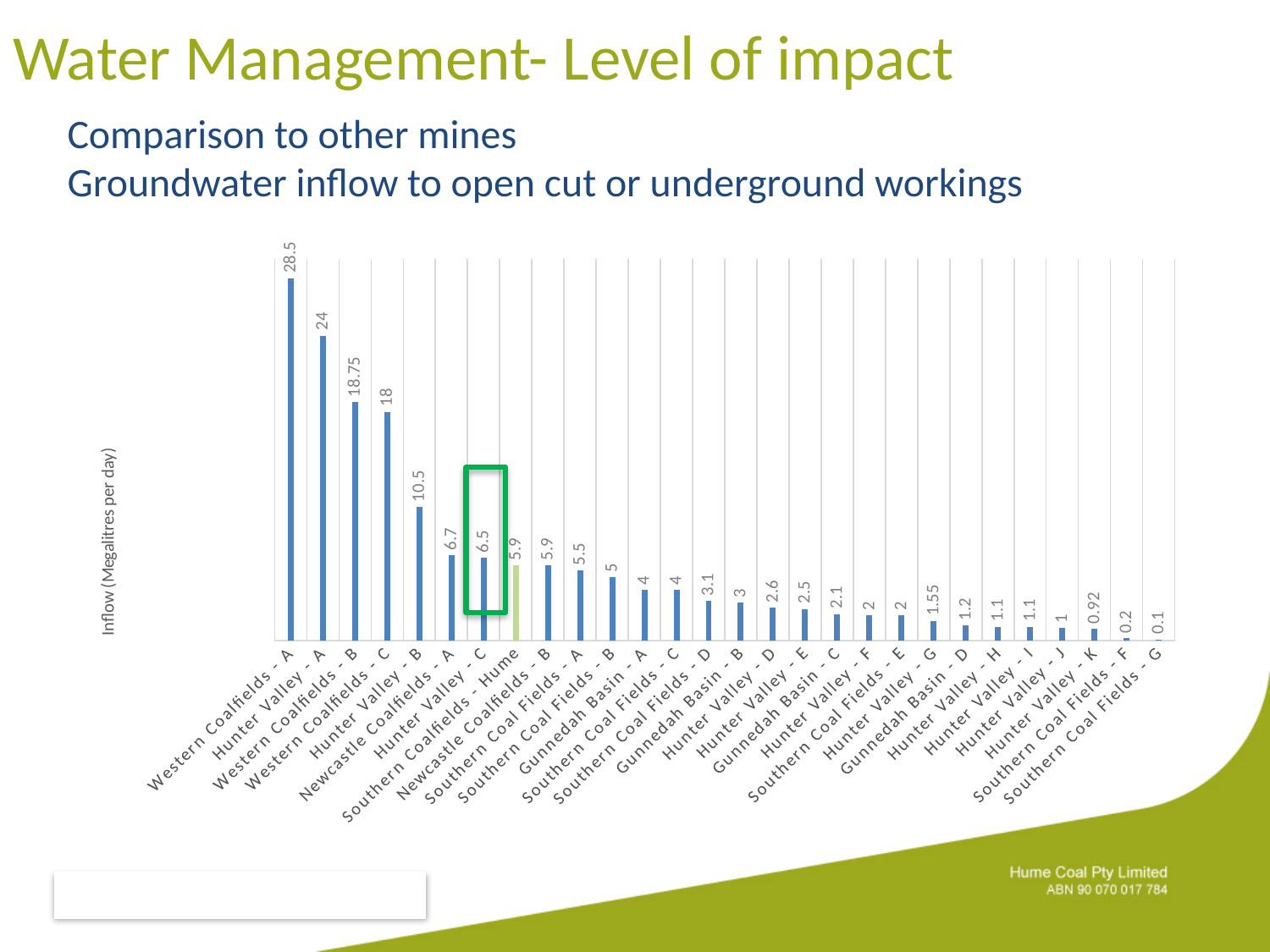
What is the value shown for Southern Coalfields - Hume? 5.9 What is the difference between the values for Western Coalfields - A and Hunter Valley - A? 4.5 What is the label on the vertical axis of the chart? Inflow (Megalitres per day) What is the groundwater inflow value for Western Coalfields - A? 28.5 What is the value shown for Hunter Valley - B? 10.5 Which mine has the highest groundwater inflow? Western Coalfields - A Which is larger, the value for Western Coalfields - B or Hunter Valley - B? Western Coalfields - B What kind of chart is shown on the slide? Bar chart What is the value shown for Hunter Valley - K? 0.92 How many mines are plotted on the chart? 28 What is the difference between the values for Hunter Valley - C and Southern Coalfields - Hume? 0.6 Which mine has the lowest groundwater inflow? Southern Coal Fields - G